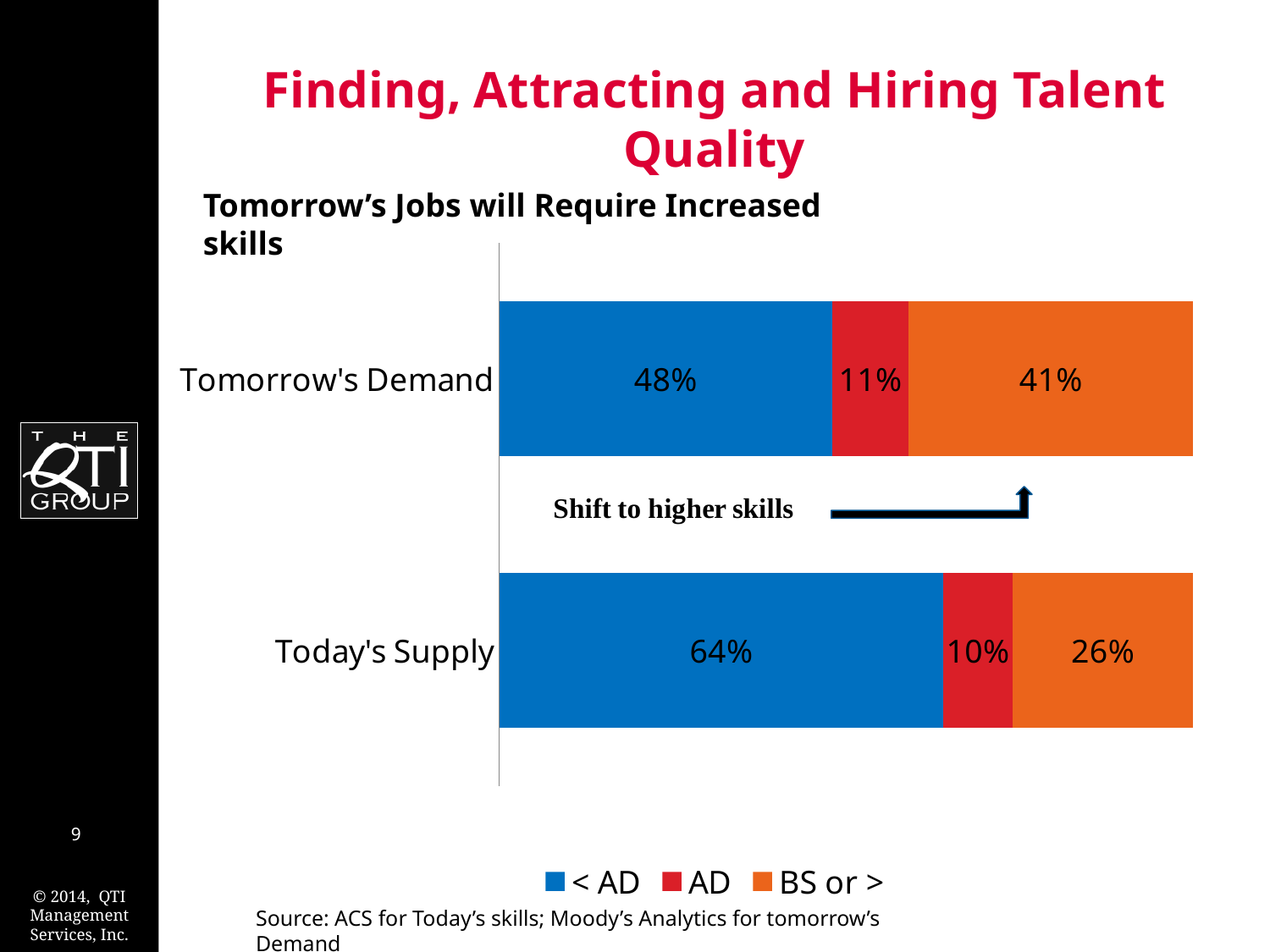
What is the value for "AD" in Tomorrow's Demand? 11% What is the value for "< AD" in Today's Supply? 64% What is the value for "< AD" in Tomorrow's Demand? 48% What is the value for "BS or >" in Today's Supply? 26% How many series does the legend list? 3 Which series has the smallest value in the Today's Supply bar? AD What is the difference between the "BS or >" values for Tomorrow's Demand and Today's Supply? 15% What kind of chart is shown on the slide? Stacked bar chart Which series has the largest value in the Tomorrow's Demand bar? < AD Which category has the higher value for "BS or >", Tomorrow's Demand or Today's Supply? Tomorrow's Demand What is the difference between the "< AD" values for Today's Supply and Tomorrow's Demand? 16% How many categories are shown on the chart? 2